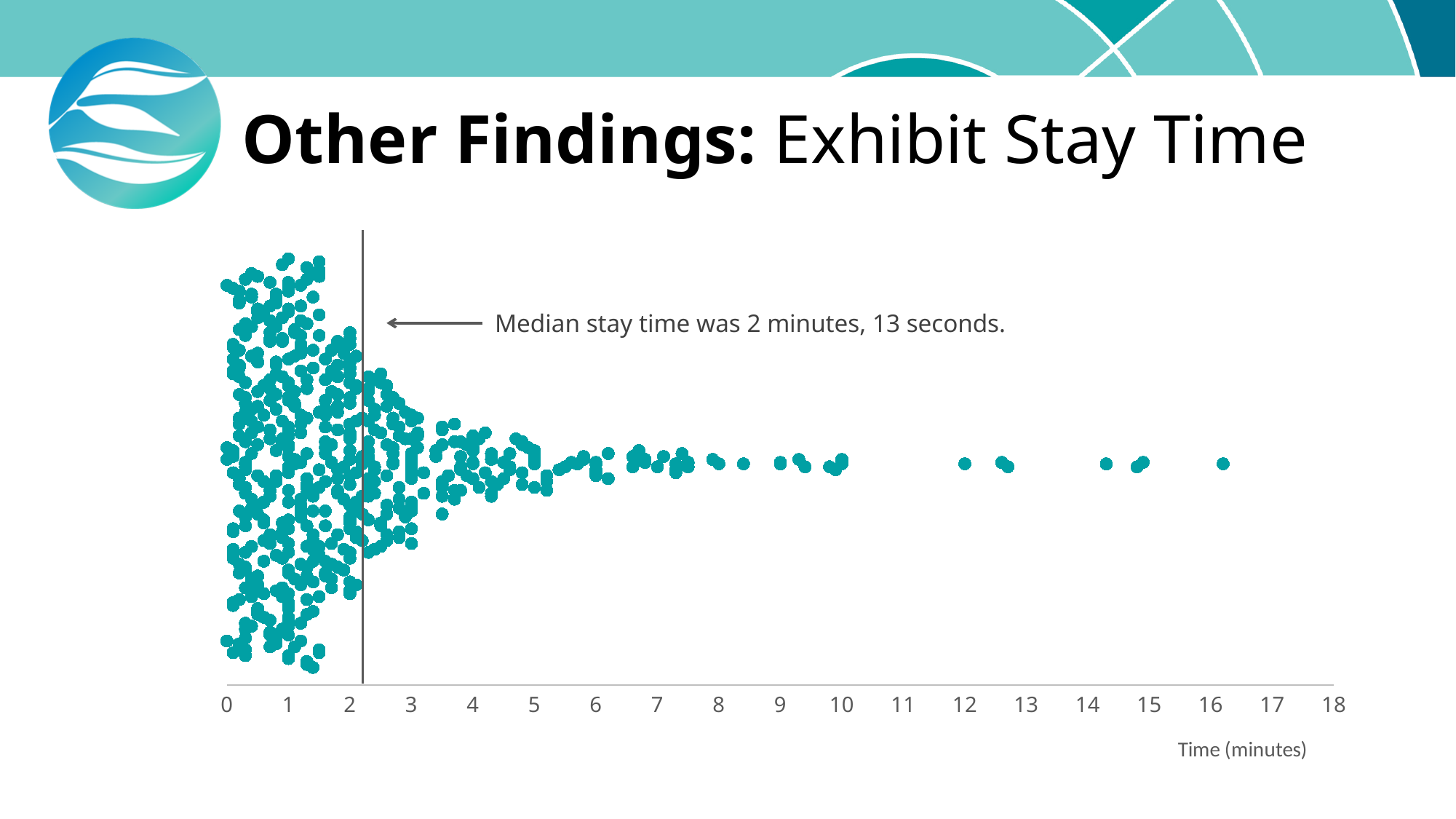
Is the median stay time marked by the vertical line greater or less than 2 minutes? greater How many points lie between 11 and 12 minutes on the x axis? 0 Does the density of plotted points increase or decrease as time increases along the x axis? decrease What is the highest tick value shown on the x axis? 18 What was the median exhibit stay time according to the annotation on the chart? 2 minutes, 13 seconds Is the longest stay time plotted greater or less than 15 minutes? greater What kind of chart is shown on the slide? dot plot Is the shortest stay time plotted greater or less than 1 minute? less What is the label of the x axis? Time (minutes)